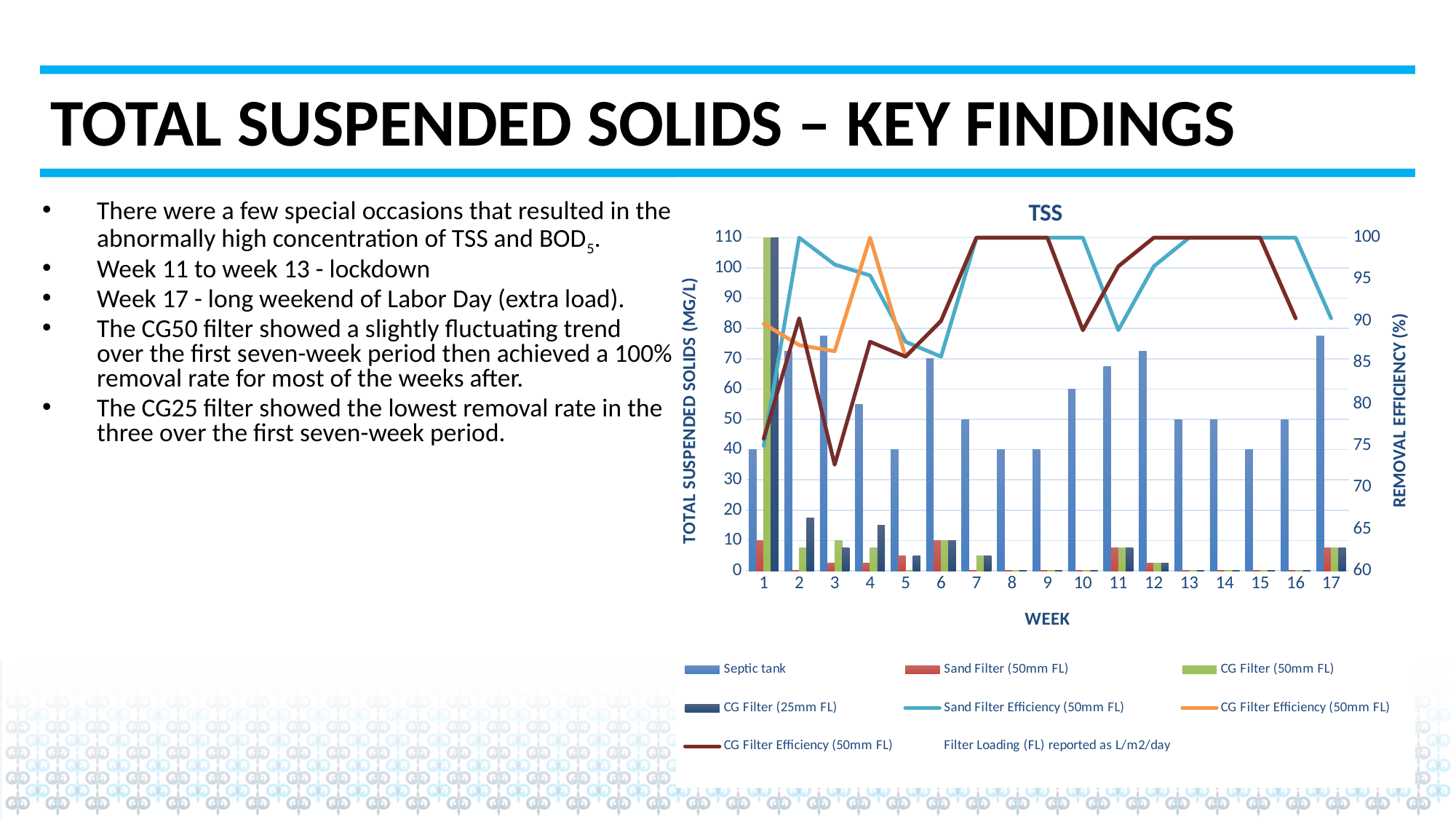
How many series does the chart legend list? 8 What is the title of the chart? TSS Which is larger, the Septic tank value for week 10 or for week 9? Week 10 What is the label of the left vertical axis? TOTAL SUSPENDED SOLIDS (MG/L) Is the Septic tank value for week 4 greater or less than 50? greater How many weeks are shown on the x axis of the chart? 17 Which is larger, the Septic tank value for week 6 or for week 5? Week 6 Is the Septic tank value for week 8 greater or less than 50? less Is the Septic tank value for week 11 greater or less than 60? greater What kind of chart is shown on the slide? Combination bar and line chart